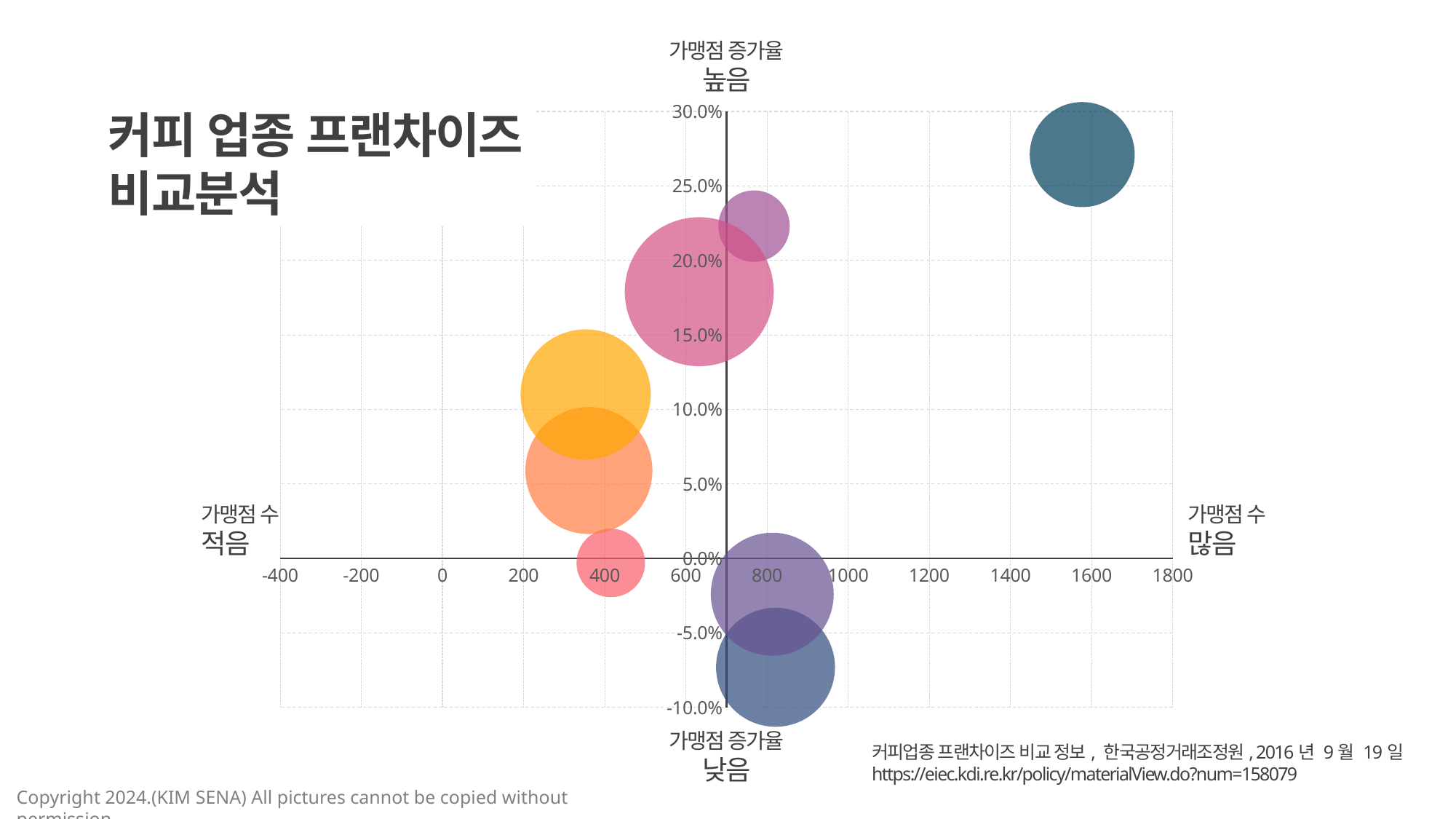
Is the number of stores for the yellow bubble greater or less than 600? less Which bubble has the highest franchise growth rate (가맹점 증가율)? the dark teal bubble in the top right What is the title of the chart on the slide? 커피 업종 프랜차이즈 비교분석 Is the growth rate for the dark teal bubble greater or less than 20.0%? greater What does the vertical axis of the chart represent? 가맹점 증가율 Which has the higher growth rate, the dark teal bubble or the yellow bubble? the dark teal bubble What kind of chart is shown on the slide? bubble chart How many bubbles are plotted on the chart? 8 Is the number of stores for the dark teal bubble greater or less than 1000? greater Which bubble has the largest number of franchise stores (가맹점 수)? the dark teal bubble in the top right Which bubble has the lowest franchise growth rate (가맹점 증가율)? the blue-grey bubble at the bottom